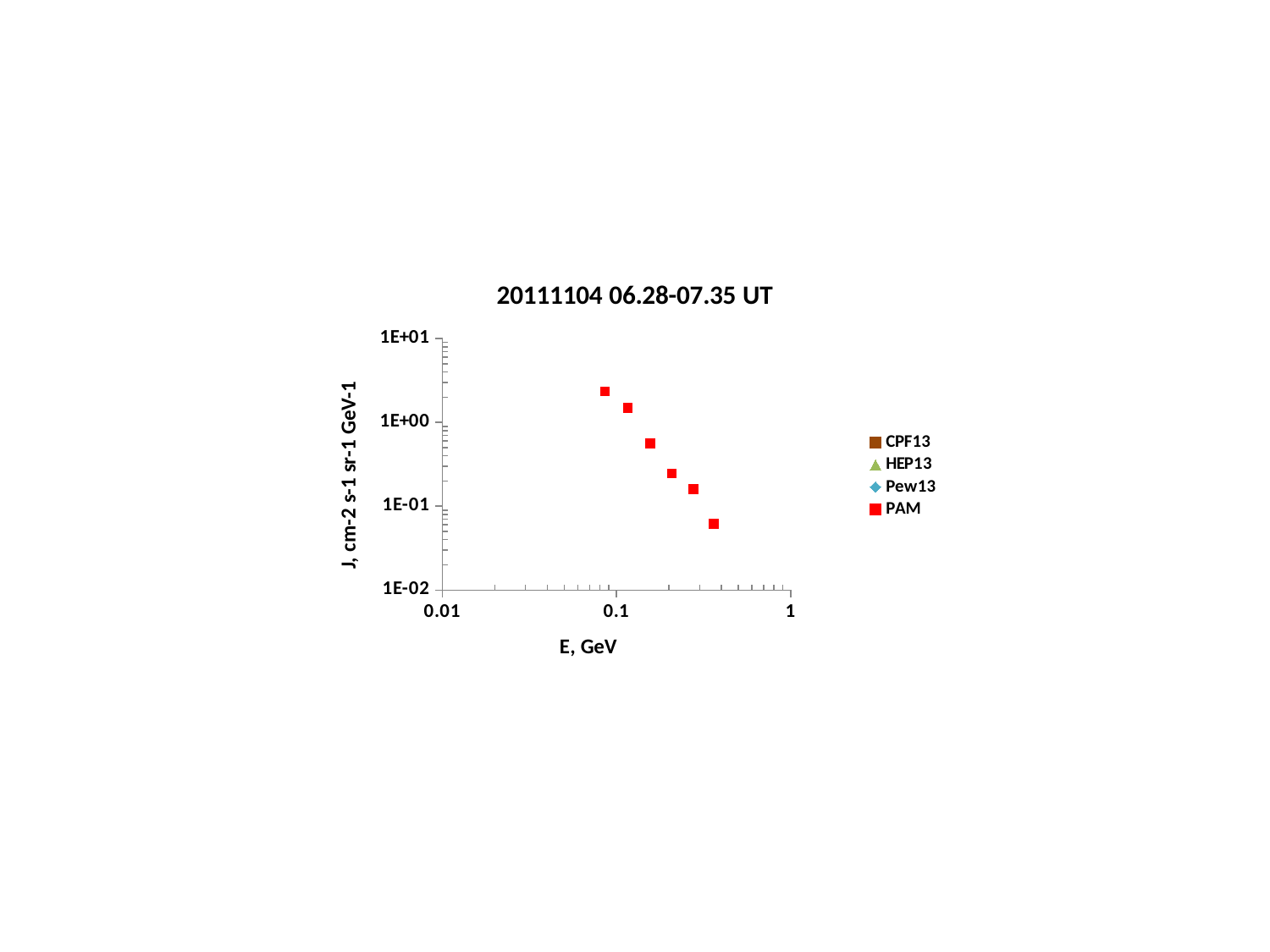
Which PAM point has the larger J value: the one at the lowest energy or the one at the highest energy? The one at the lowest energy What kind of chart is shown on the slide? Scatter chart Is the value for the PAM point at the highest energy greater or less than 1E-02? greater Are all the plotted PAM points at energies greater or less than 1 GeV? less How many PAM data points are plotted on the chart? 6 How many series does the legend list? 4 Is the value for the PAM point at the lowest energy greater or less than 1E+01? less Which legend series has visible data points plotted on the chart? PAM Do the PAM values rise or fall as energy E increases along the x axis? Fall What is the title of the chart? 20111104 06.28-07.35 UT